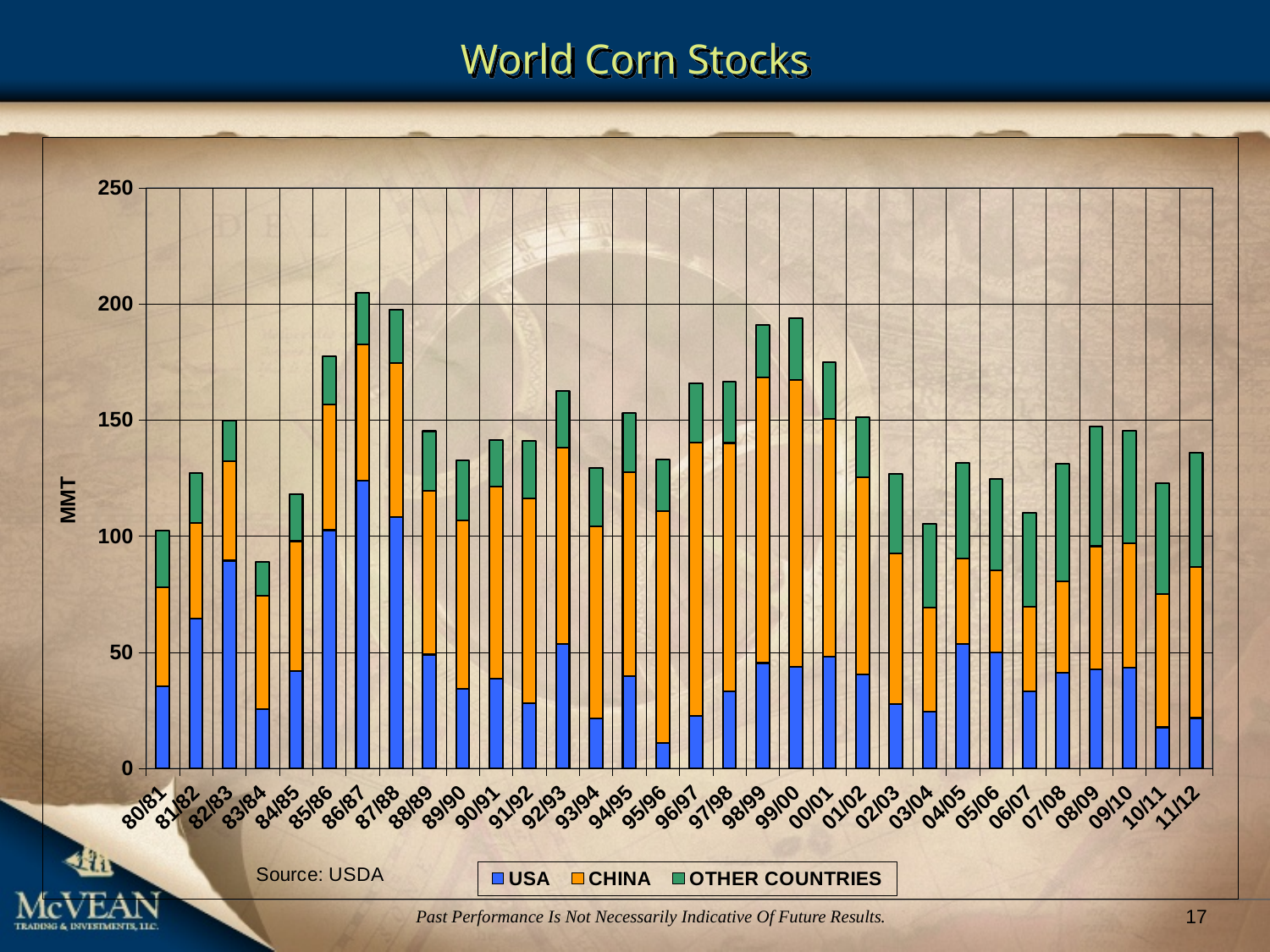
What unit is shown on the y axis label? MMT Is the USA value for 86/87 greater or less than 100? greater How many series does the legend list? 3 Is the total stacked value for 86/87 greater or less than 200? greater How many marketing years are shown along the x axis? 32 Which marketing year has the lowest total world corn stocks? 83/84 Is the USA value for 95/96 greater or less than 50? less What is the title of the chart? World Corn Stocks What kind of chart is shown on the slide? stacked bar chart Which marketing year has the highest total world corn stocks? 86/87 Which has the larger total world corn stocks, 98/99 or 03/04? 98/99